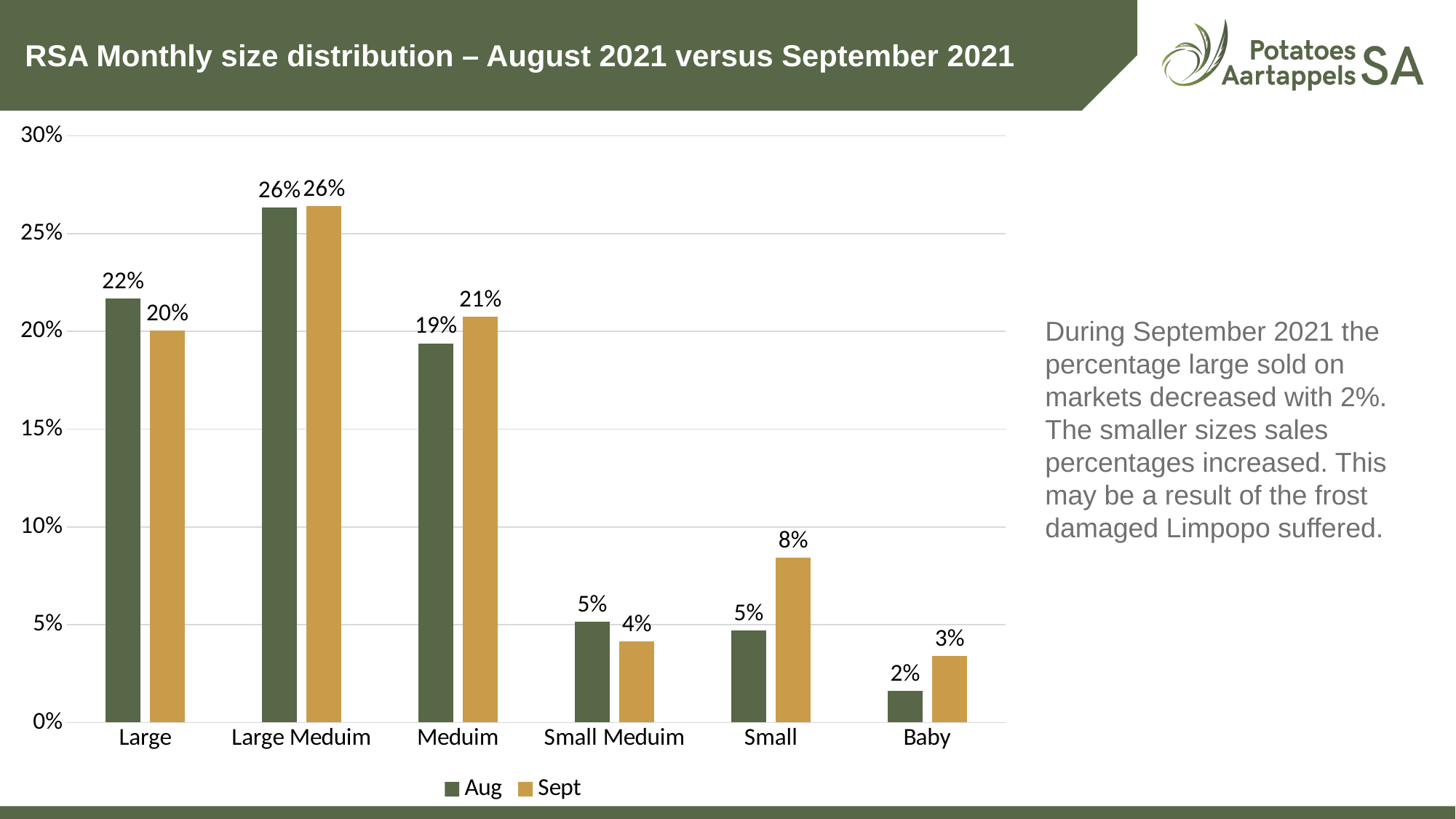
What is the difference between the Sept and Aug values for Small? 3% What is the Sept value for Meduim? 21% How many size categories are shown on the x axis? 6 Which category has the highest Sept value? Large Meduim How many series does the legend list? 2 What is the Aug value for Large? 22% What is the Aug value for Baby? 2% Which category has the lowest Aug value? Baby Which is larger for Small Meduim, the Aug value or the Sept value? Aug What kind of chart is shown on the slide? Bar chart What is the Sept value for Small? 8% Which colour represents the Sept series? Gold